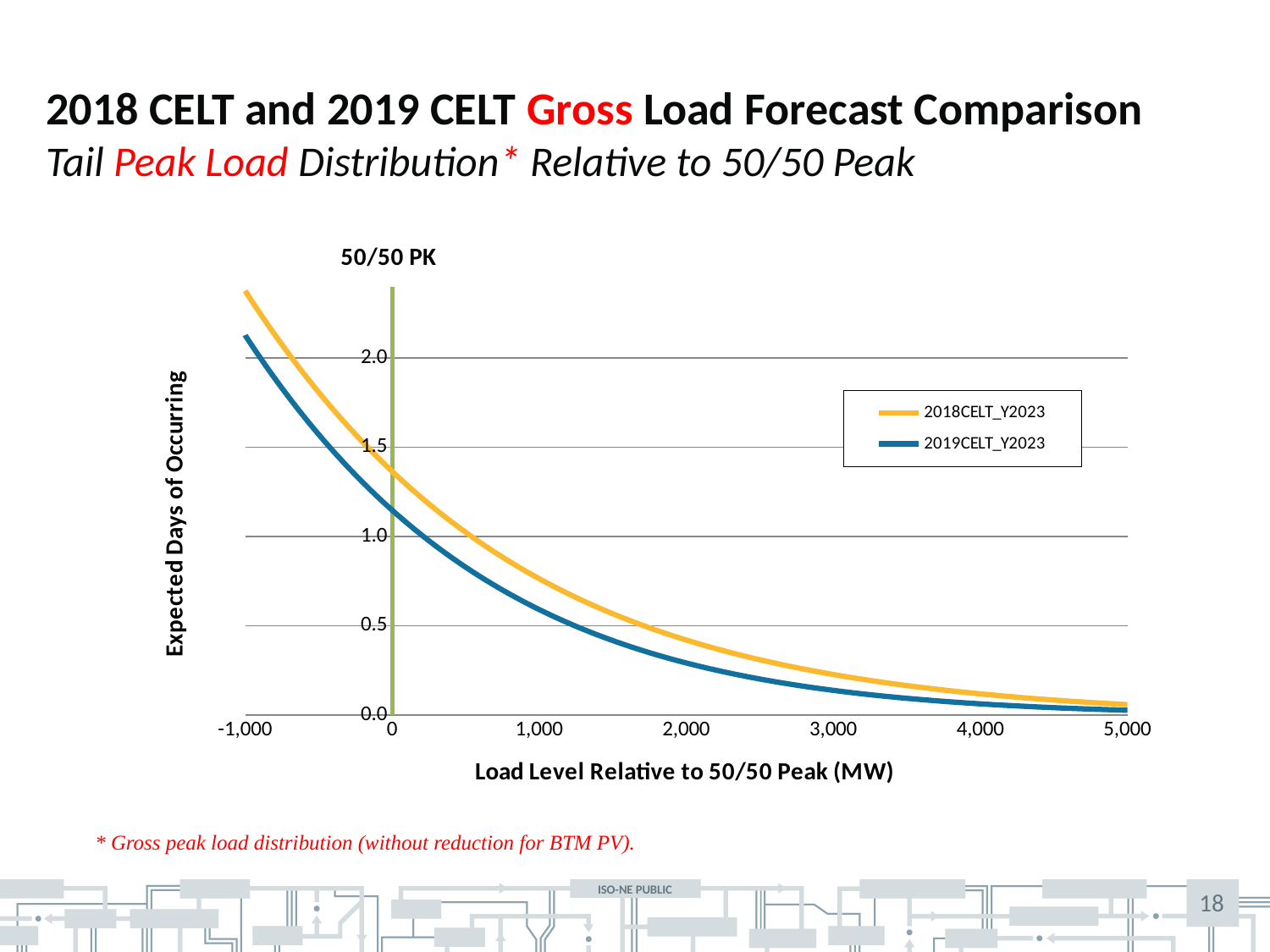
Is the value for 2018CELT_Y2023 at a load level of -1,000 MW greater or less than 2.0? greater What kind of chart is shown on the slide? Line chart Do the values of the 2018CELT_Y2023 series rise or fall as the load level increases along the x axis? Fall Do the values of the 2019CELT_Y2023 series rise or fall as the load level increases along the x axis? Fall Which two series are listed in the chart legend? 2018CELT_Y2023 and 2019CELT_Y2023 At a load level of 2,000 MW, which series has the lower expected days of occurring, 2018CELT_Y2023 or 2019CELT_Y2023? 2019CELT_Y2023 Is the value for 2018CELT_Y2023 at a load level of 0 MW greater or less than 1.0? greater Is the value for 2018CELT_Y2023 at a load level of 2,000 MW greater or less than 0.5? less How many series does the chart legend list? 2 What is the title of the chart's x axis? Load Level Relative to 50/50 Peak (MW) At a load level of 0 MW, which series has the higher expected days of occurring, 2018CELT_Y2023 or 2019CELT_Y2023? 2018CELT_Y2023